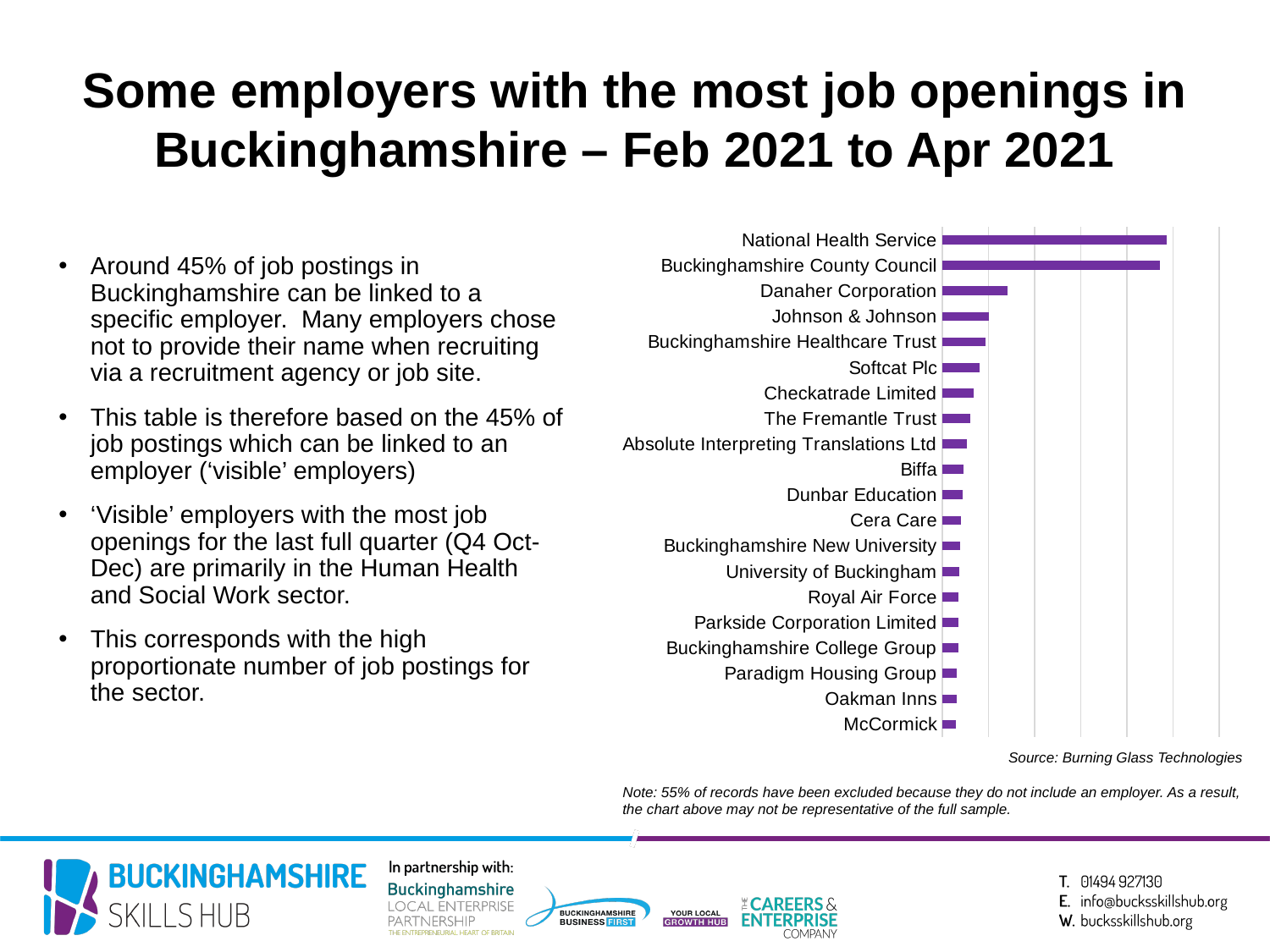
Which has the longer bar, Danaher Corporation or Johnson & Johnson? Danaher Corporation What kind of chart is shown on the slide? Bar chart Which has the longer bar, Checkatrade Limited or Oakman Inns? Checkatrade Limited How many employers are listed in the chart? 20 Which has the longer bar, National Health Service or Danaher Corporation? National Health Service Do the bar lengths generally increase or decrease going from the top of the chart to the bottom? Decrease What colour are the bars in the chart? Purple Which employer is listed at the top of the chart? National Health Service Are the bars in the chart drawn horizontally or vertically? Horizontally